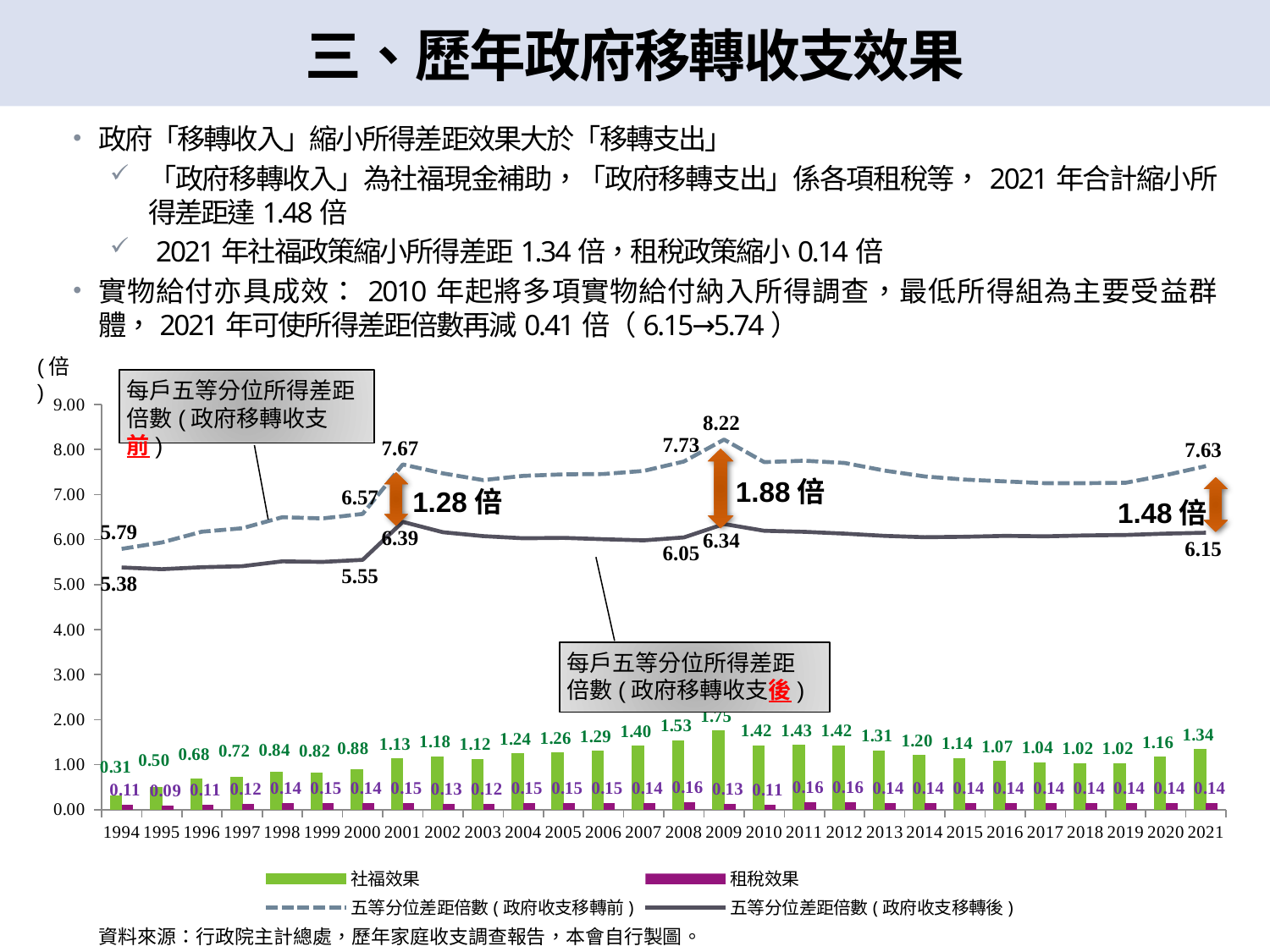
What is the 租稅效果 value for 2008? 0.16 What is the value of 五等分位差距倍數(政府收支移轉前) in 2009? 8.22 How many series does the legend list? 4 What is the difference between the 政府收支移轉前 and 政府收支移轉後 values in 2021? 1.48 How many years are shown on the x axis? 28 In which year is the 社福效果 bar lowest? 1994 Which is larger in 2001: the 社福效果 value or the 租稅效果 value? 社福效果 What is the difference between the 社福效果 values for 2009 and 2010? 0.33 In which year is the 社福效果 bar highest? 2009 What is the value of 五等分位差距倍數(政府收支移轉後) in 1994? 5.38 Is the 政府收支移轉前 value for 2009 greater or less than 8.00? greater What is the 社福效果 value for 2021? 1.34